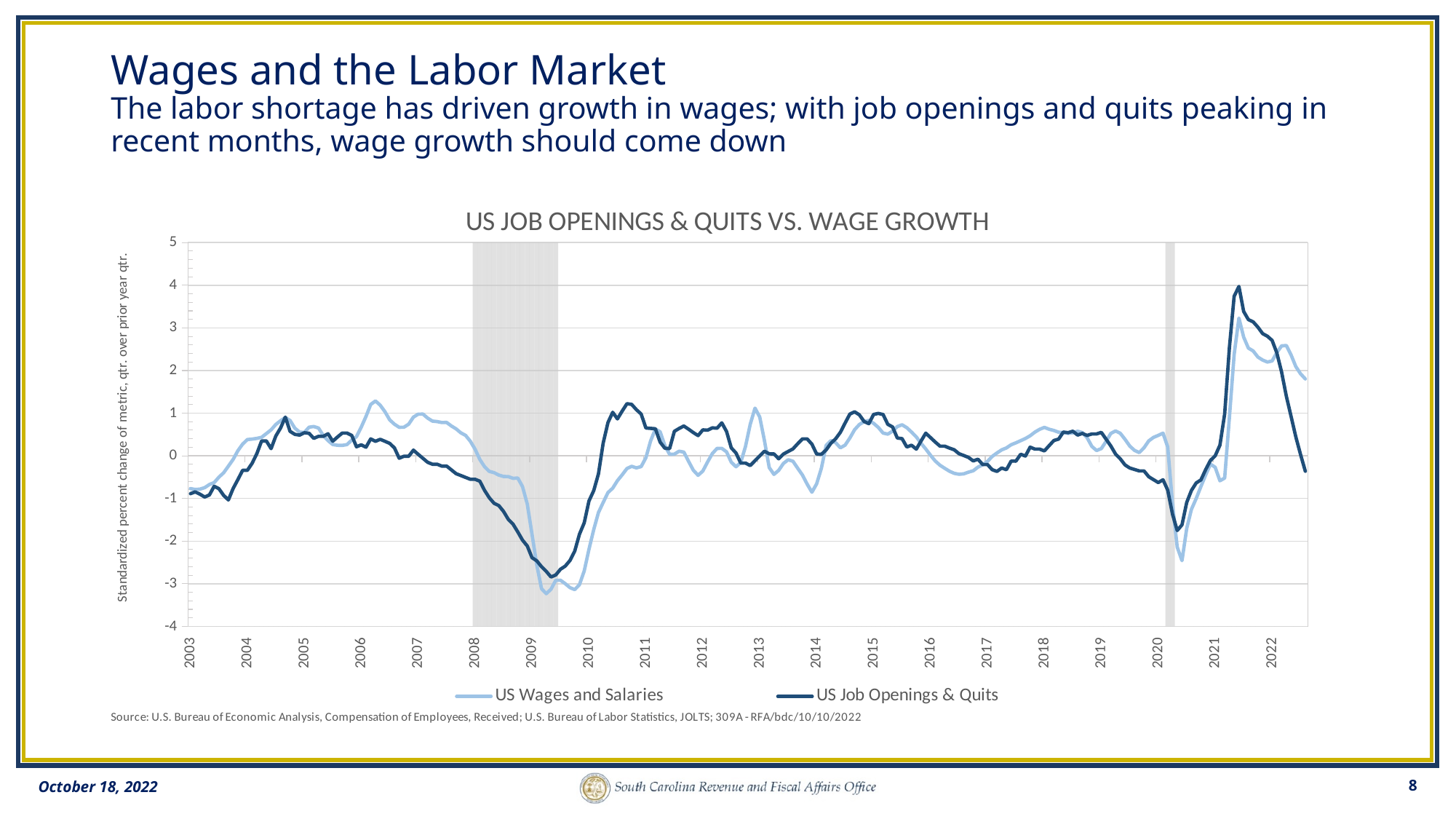
Which series reaches the highest value anywhere on the chart? US Job Openings & Quits Is the lowest value of US Wages and Salaries in 2009 greater or less than -3? less What kind of chart is shown on the slide? Line chart At the end of the series in 2022, which is higher: US Wages and Salaries or US Job Openings & Quits? US Wages and Salaries Is the peak value of US Wages and Salaries in 2021 greater or less than 2? greater Which series is drawn in the darker blue line? US Job Openings & Quits From its 2021 peak to the end of 2022, does US Job Openings & Quits rise or fall? fall Is the lowest value of US Job Openings & Quits in 2009 greater or less than -2? less What is the title of the chart? US JOB OPENINGS & QUITS VS. WAGE GROWTH How many year labels are shown on the x axis? 20 How many series does the legend list? 2